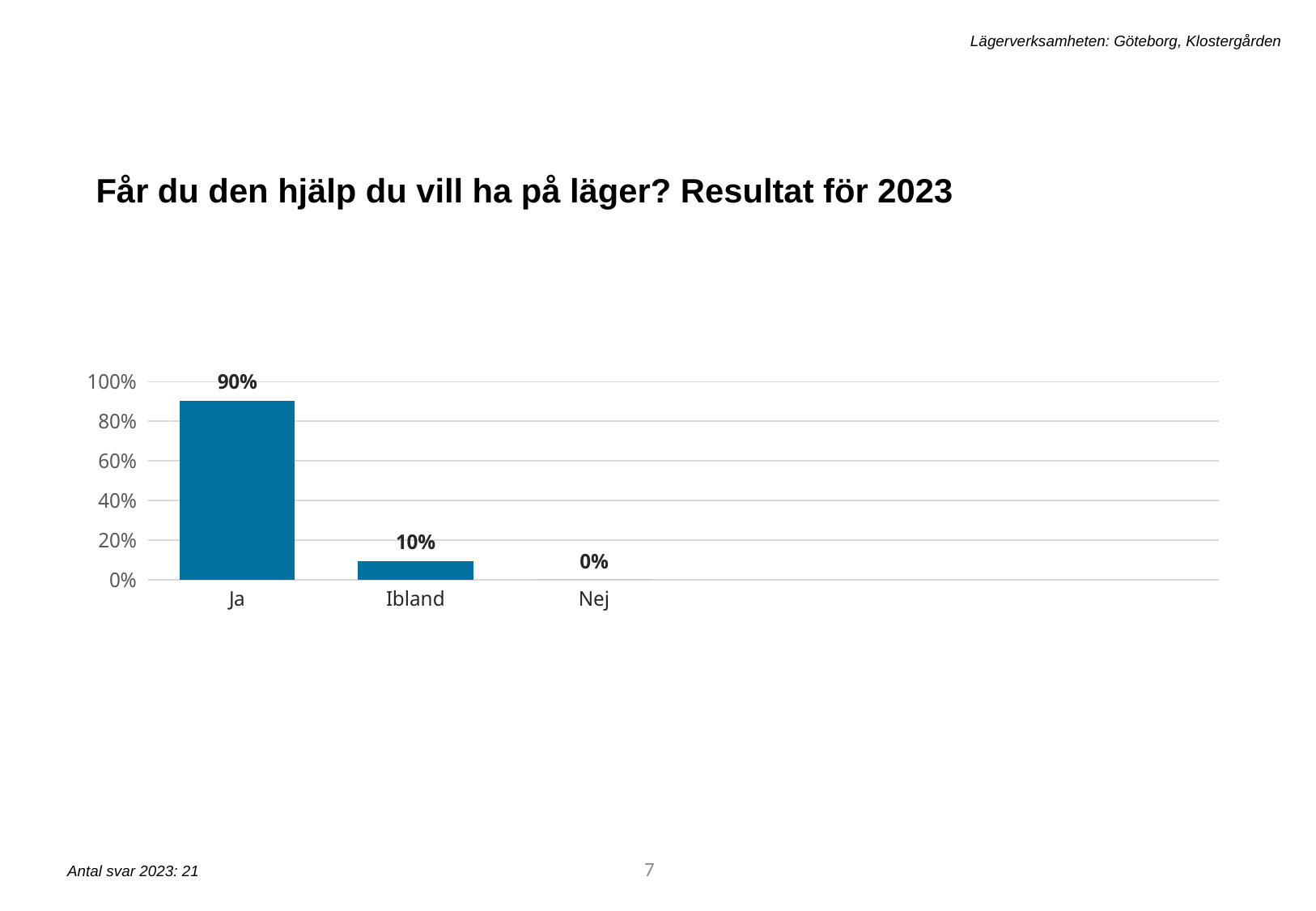
Which category has the lowest value? Nej What is the value for Nej? 0% Which is larger, the value for Ibland or the value for Nej? Ibland What is the value for Ja? 90% What is the value for Ibland? 10% What is the title of the slide above the chart? Får du den hjälp du vill ha på läger? Resultat för 2023 Is the value for Ja greater or less than 80%? greater What is the difference between the values for Ja and Ibland? 80% Which category has the highest value? Ja Do the values rise or fall from left to right along the x axis? fall What kind of chart is shown on the slide? bar chart How many categories are shown on the x axis? 3